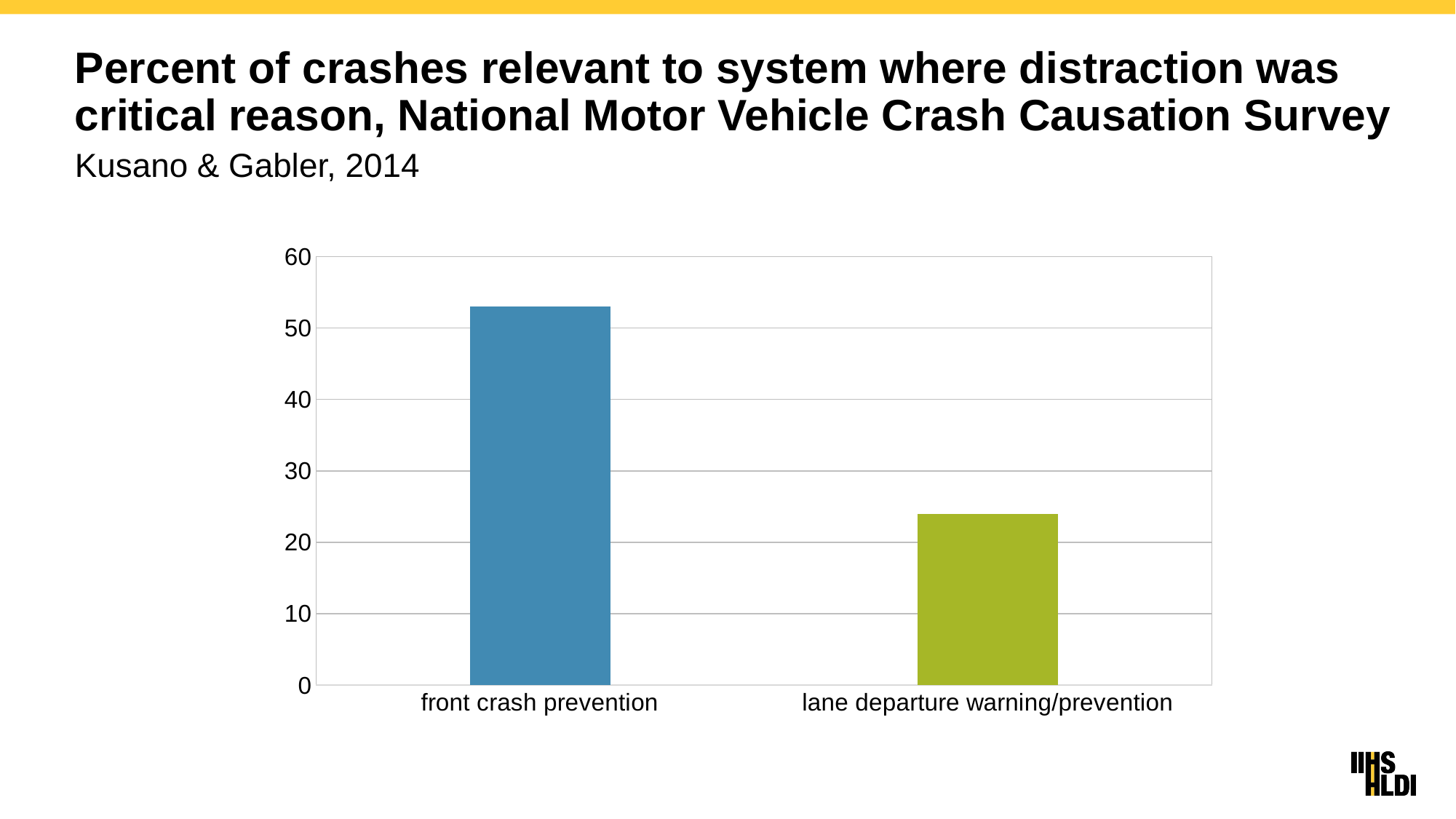
Which category has the highest value? front crash prevention What is the highest value shown on the vertical axis? 60 Which category has the lowest value? lane departure warning/prevention Is the value for lane departure warning/prevention greater or less than 30? less What colour is the bar for front crash prevention? blue Is the value for front crash prevention greater or less than 60? less Is the value for front crash prevention greater or less than 50? greater How many categories are plotted in the chart? 2 Which is larger, the value for front crash prevention or the value for lane departure warning/prevention? front crash prevention What kind of chart is shown on the slide? bar chart